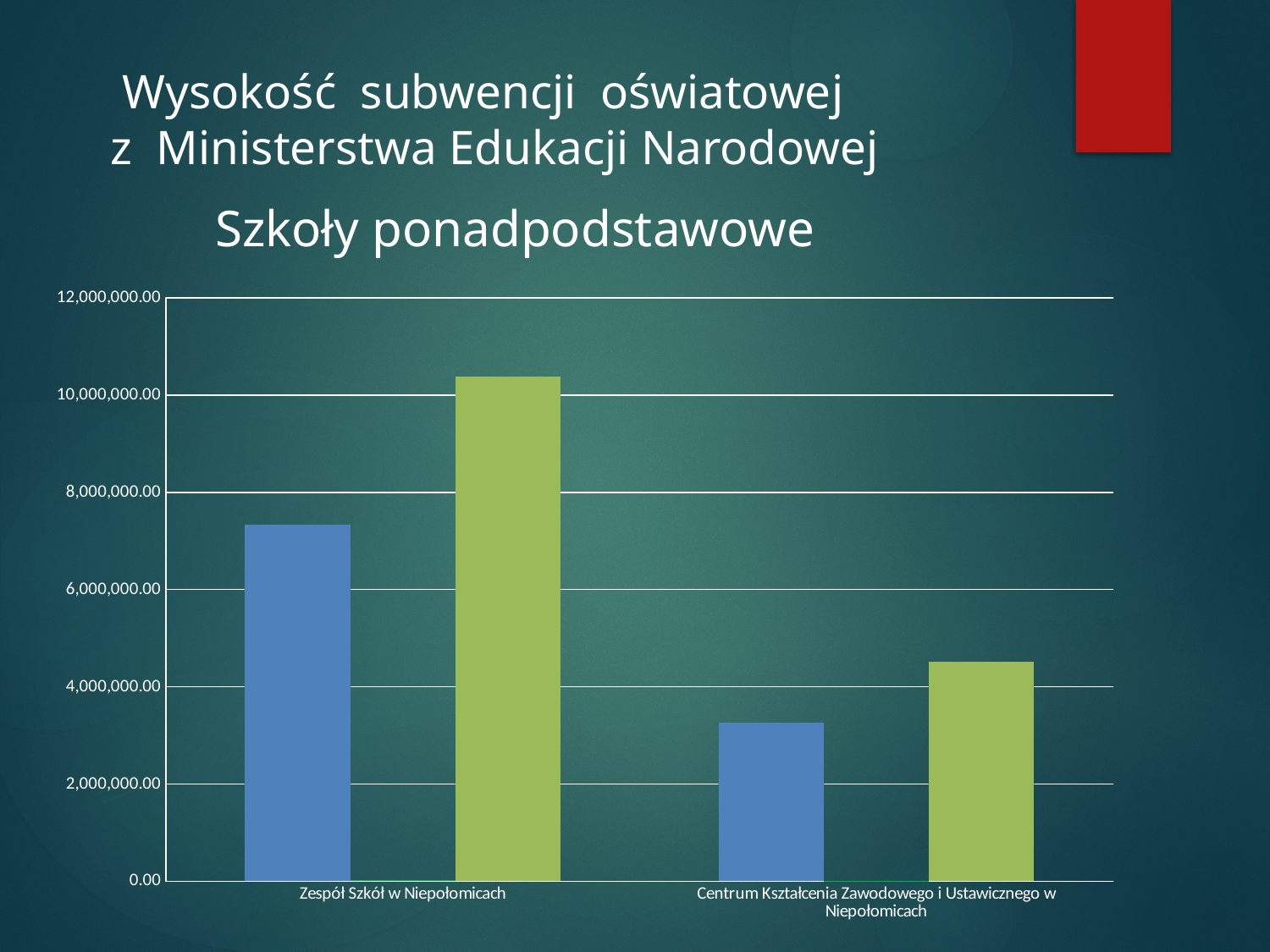
For Zespół Szkół w Niepołomicach, which bar is taller, the blue one or the green one? the green one Is the value of the green bar for Centrum Kształcenia Zawodowego i Ustawicznego w Niepołomicach greater or less than 4,000,000.00? greater Is the value of the blue bar for Zespół Szkół w Niepołomicach greater or less than 6,000,000.00? greater What kind of chart is shown on the slide? bar chart What is the title shown directly above the chart? Szkoły ponadpodstawowe Which category has the shortest bar in the chart? Centrum Kształcenia Zawodowego i Ustawicznego w Niepołomicach Which category has the larger blue bar, Zespół Szkół w Niepołomicach or Centrum Kształcenia Zawodowego i Ustawicznego w Niepołomicach? Zespół Szkół w Niepołomicach What is the highest value shown on the vertical axis of the chart? 12,000,000.00 Is the value of the blue bar for Centrum Kształcenia Zawodowego i Ustawicznego w Niepołomicach greater or less than 4,000,000.00? less Which category has the tallest bar in the chart? Zespół Szkół w Niepołomicach How many categories are shown on the x axis of the chart? 2